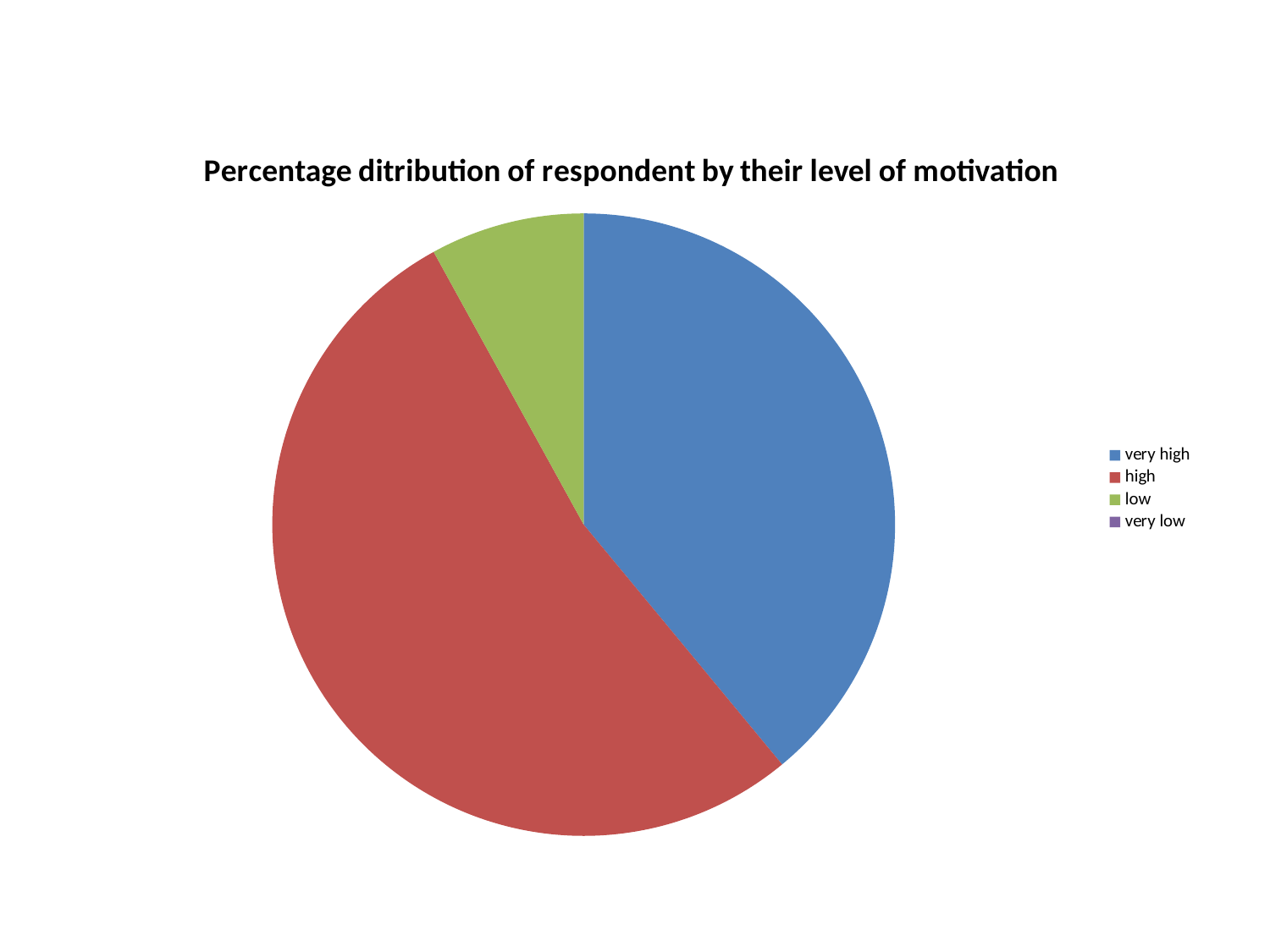
What is the title of the chart? Percentage ditribution of respondent by their level of motivation Which level of motivation has the largest slice of the pie? high Which slice is larger, very high or low? very high Which of the visible slices is the smallest? low Which slice is larger, very high or high? high How many entries does the legend list? 4 How many slices are visible in the pie? 3 What kind of chart is shown on the slide? pie chart Which colour represents the 'very high' category? blue